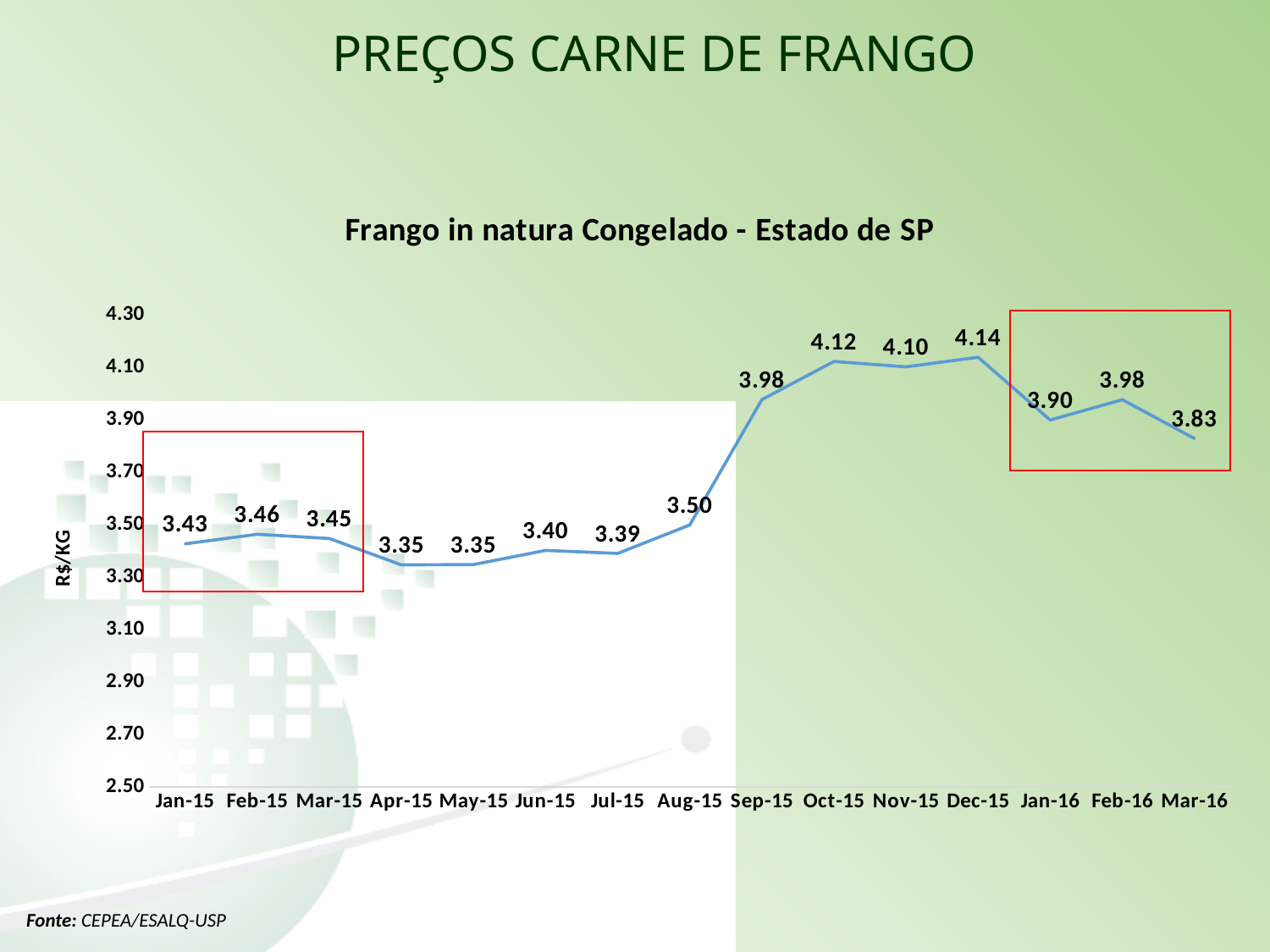
Does the value rise or fall from Aug-15 to Sep-15? rise What is the value for Jan-15? 3.43 What is the label of the y axis? R$/KG Which is larger, the value for Oct-15 or the value for Nov-15? Oct-15 What is the difference between the values for Dec-15 and Jan-16? 0.24 Which month has the highest value? Dec-15 What is the lowest value plotted on the chart? 3.35 What type of chart is shown on the slide? line chart What is the title of the chart? Frango in natura Congelado - Estado de SP What is the value for Mar-16? 3.83 What is the value for Sep-15? 3.98 How many months are plotted on the x axis? 15